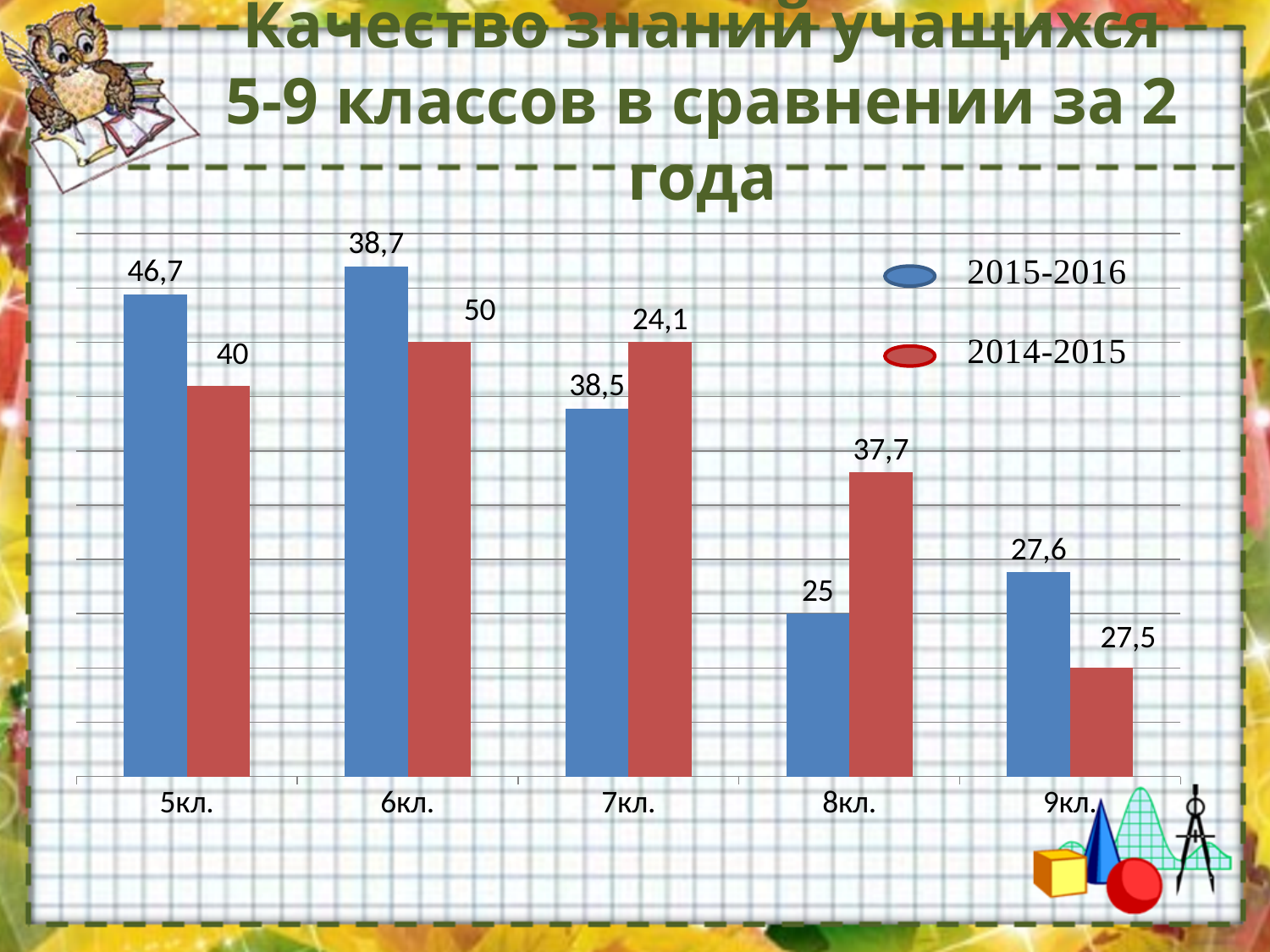
Which class has the lowest value in the 2015-2016 series? 8кл. What is the difference between the 2014-2015 and 2015-2016 values for 8кл.? 12,7 For 8кл., which series has the larger value, 2015-2016 or 2014-2015? 2014-2015 What is the value for 7кл. in the 2014-2015 series? 24,1 What is the value for 6кл. in the 2014-2015 series? 50 What is the value for 8кл. in the 2015-2016 series? 25 How many classes (categories) are shown on the x axis? 5 What is the value for 5кл. in the 2015-2016 series? 46,7 What kind of chart is shown on the slide? Bar chart For 5кл., which series has the larger value, 2015-2016 or 2014-2015? 2015-2016 How many series does the legend list? 2 What is the value for 9кл. in the 2014-2015 series? 27,5